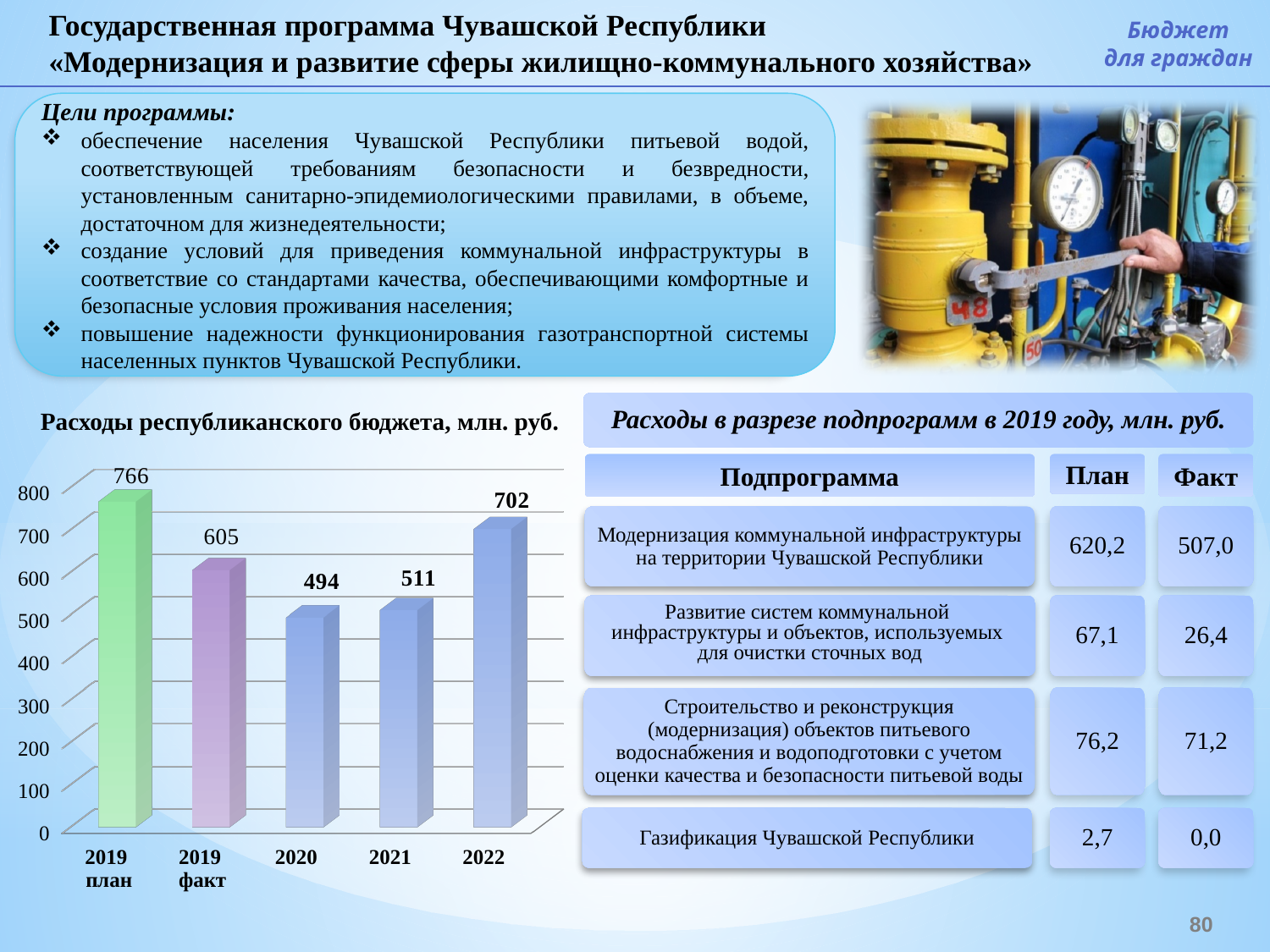
What is the difference between the 2022 and 2021 values in the chart 'Расходы республиканского бюджета, млн. руб.'? 191 Which category has the lowest value in the chart 'Расходы республиканского бюджета, млн. руб.'? 2020 What is the difference between the 2019 план and 2019 факт values in the chart 'Расходы республиканского бюджета, млн. руб.'? 161 How many bars are shown in the chart 'Расходы республиканского бюджета, млн. руб.'? 5 Which category has the highest value in the chart 'Расходы республиканского бюджета, млн. руб.'? 2019 план What is the value for 2019 факт in the chart 'Расходы республиканского бюджета, млн. руб.'? 605 What is the value for 2020 in the chart 'Расходы республиканского бюджета, млн. руб.'? 494 What is the value for 2022 in the chart 'Расходы республиканского бюджета, млн. руб.'? 702 What is the value for 2019 план in the chart 'Расходы республиканского бюджета, млн. руб.'? 766 Do the values rise or fall from 2020 to 2022 in the chart 'Расходы республиканского бюджета, млн. руб.'? Rise What kind of chart is 'Расходы республиканского бюджета, млн. руб.'? Bar chart Which is larger in the chart 'Расходы республиканского бюджета, млн. руб.': the value for 2021 or the value for 2020? 2021